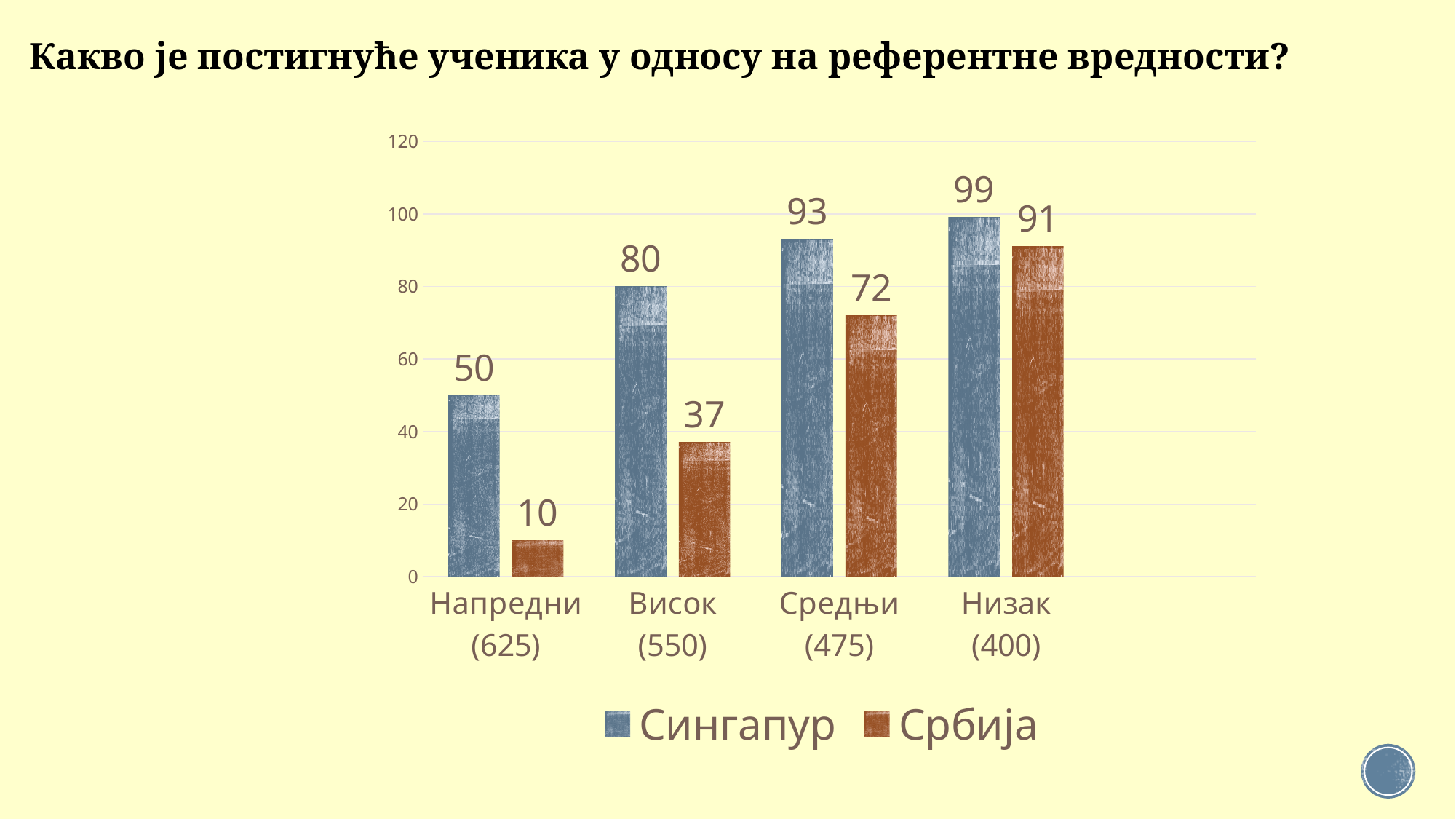
What is the value for Србија in the Средњи (475) category? 72 Which is larger in the Висок (550) category, Сингапур or Србија? Сингапур Which category has the highest value for Сингапур? Низак (400) What is the value for Србија in the Напредни (625) category? 10 What is the value for Сингапур in the Висок (550) category? 80 What kind of chart is shown on the slide? Bar chart How many series does the legend list? 2 Do the values for Србија rise or fall from Напредни (625) to Низак (400)? Rise How many categories are shown on the x axis? 4 Which category has the lowest value for Србија? Напредни (625) What is the difference between Сингапур and Србија in the Низак (400) category? 8 What is the difference between Сингапур and Србија in the Напредни (625) category? 40